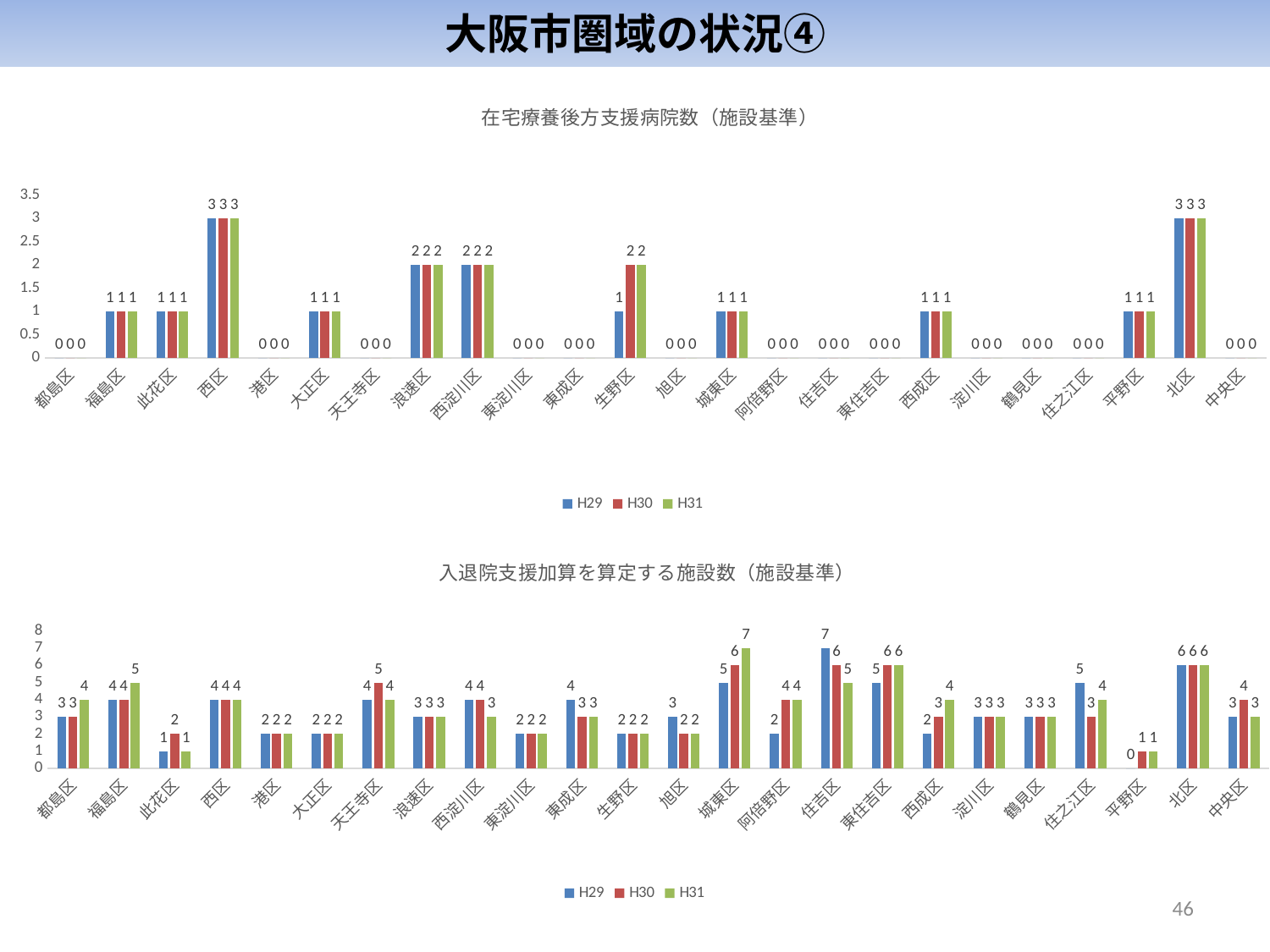
In the bottom chart (入退院支援加算を算定する施設数), what is the H29 value for 住吉区? 7 In the bottom chart (入退院支援加算を算定する施設数), do the values for 城東区 rise or fall from H29 to H31? rise In the bottom chart (入退院支援加算を算定する施設数), what is the H31 value for 城東区? 7 In the top chart (在宅療養後方支援病院数), what is the H31 value for 生野区? 2 In the top chart (在宅療養後方支援病院数), what is the H29 value for 生野区? 1 In the bottom chart (入退院支援加算を算定する施設数), which is larger: the H30 value for 天王寺区 or the H30 value for 西淀川区? 天王寺区 What kind of chart is the bottom chart (入退院支援加算を算定する施設数)? bar chart How many series does the legend of the top chart list? 3 In the bottom chart (入退院支援加算を算定する施設数), what is the difference between the H29 and H31 values for 住吉区? 2 In the top chart (在宅療養後方支援病院数), which wards have the highest H31 value? 西区 and 北区 How many wards (categories) are shown on the x axis of the bottom chart? 24 In the bottom chart (入退院支援加算を算定する施設数), which ward has the lowest H29 value? 平野区